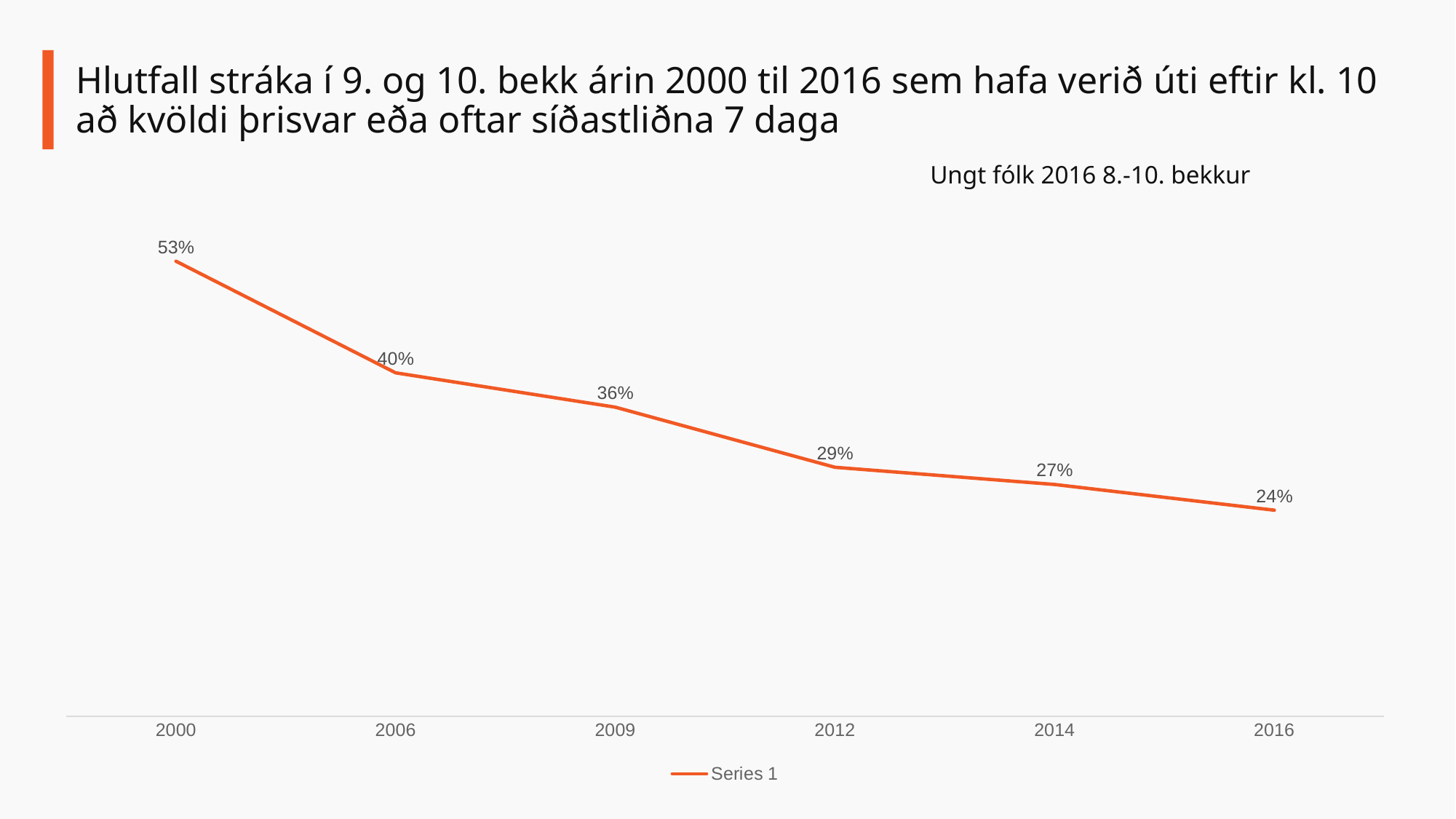
How many years are plotted on the x axis? 6 What series name does the legend show? Series 1 Which year has the lowest value? 2016 Do the values rise or fall from 2000 to 2016? fall Which is larger, the value for 2012 or the value for 2014? 2012 Which year has the highest value? 2000 What is the value for 2016? 24% What is the difference between the values for 2000 and 2016? 29% What is the value for 2009? 36% What is the difference between the values for 2006 and 2012? 11% What is the value for 2000? 53% What type of chart is shown on the slide? line chart